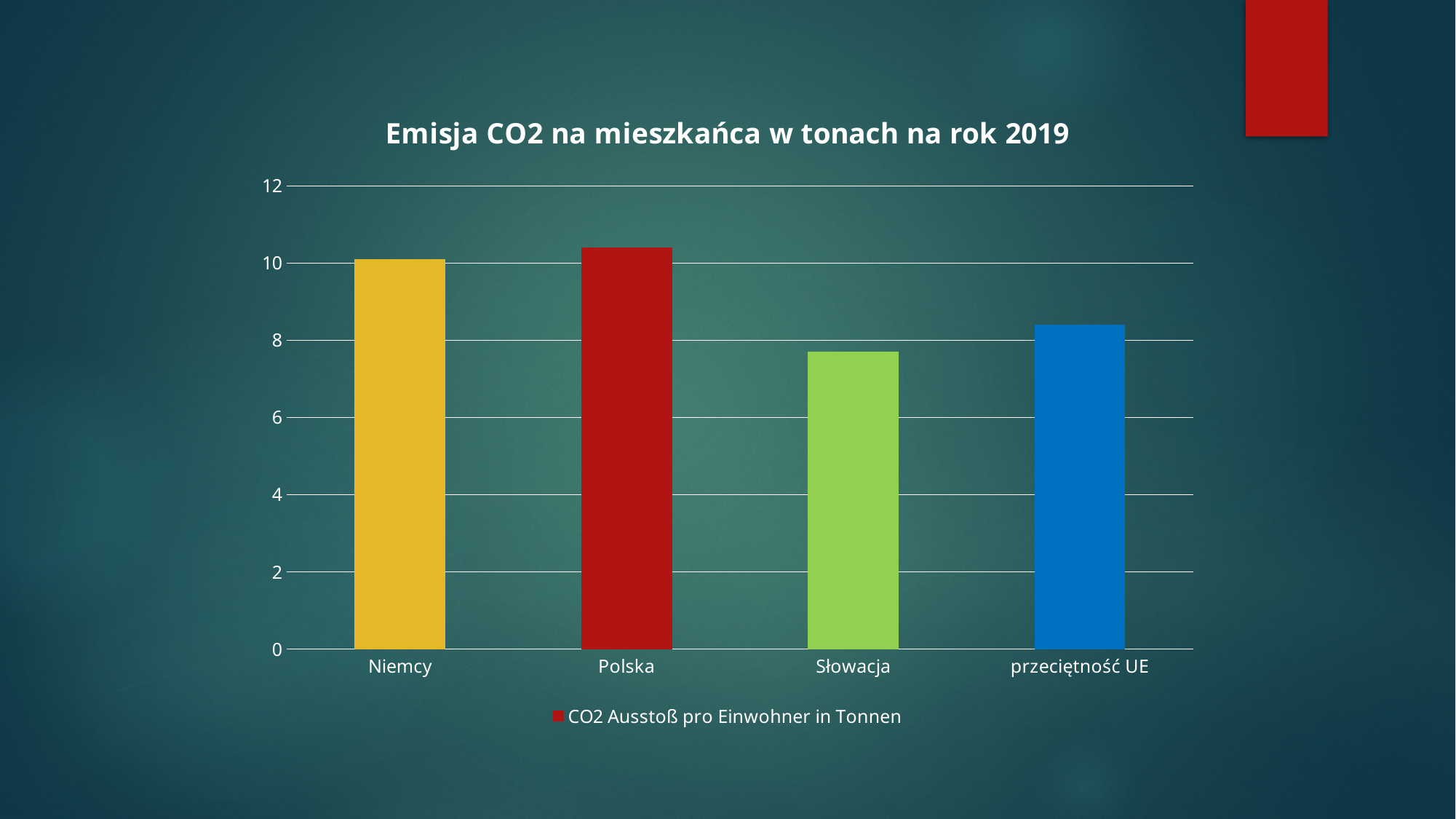
What kind of chart is shown on the slide? bar chart Which category has the highest value in the chart? Polska Which is larger, the value for Niemcy or the value for Słowacja? Niemcy Is the value for Polska greater or less than 10? greater Which is larger, the value for Słowacja or the value for przeciętność UE? przeciętność UE Is the value for Słowacja greater or less than 8? less How many categories are shown on the x axis of the chart? 4 How many series does the chart's legend list? 1 What is the legend entry of the chart? CO2 Ausstoß pro Einwohner in Tonnen What is the title of the chart? Emisja CO2 na mieszkańca w tonach na rok 2019 Is the value for przeciętność UE greater or less than 10? less Which category has the lowest value in the chart? Słowacja